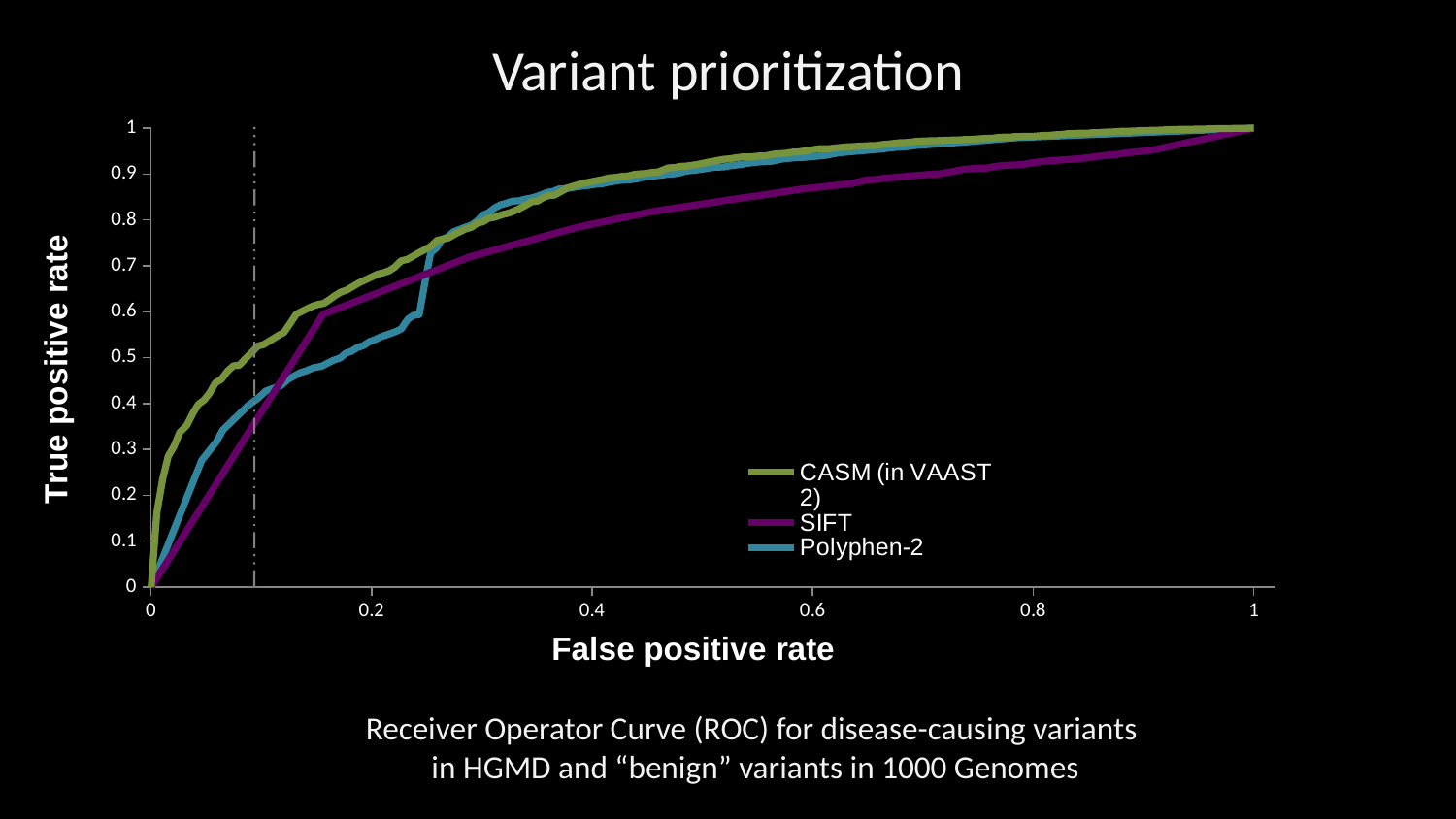
What is the title of the chart? Variant prioritization At a false positive rate of 0.1, which series has the highest true positive rate? CASM (in VAAST 2) Is the true positive rate for CASM (in VAAST 2) at a false positive rate of 0.2 greater or less than 0.5? greater At a false positive rate of 0.6, which series has the lower true positive rate, CASM (in VAAST 2) or SIFT? SIFT Does the true positive rate for SIFT rise or fall as the false positive rate increases? Rise At a false positive rate of 0.2, which series has the higher true positive rate, CASM (in VAAST 2) or Polyphen-2? CASM (in VAAST 2) Is the true positive rate for Polyphen-2 at a false positive rate of 0.1 greater or less than 0.5? less At a false positive rate of 0.8, which series has the lowest true positive rate? SIFT Is the true positive rate for SIFT at a false positive rate of 0.6 greater or less than 0.9? less What is the label of the x axis? False positive rate What kind of chart is shown on the slide? Line chart How many series does the legend list? 3